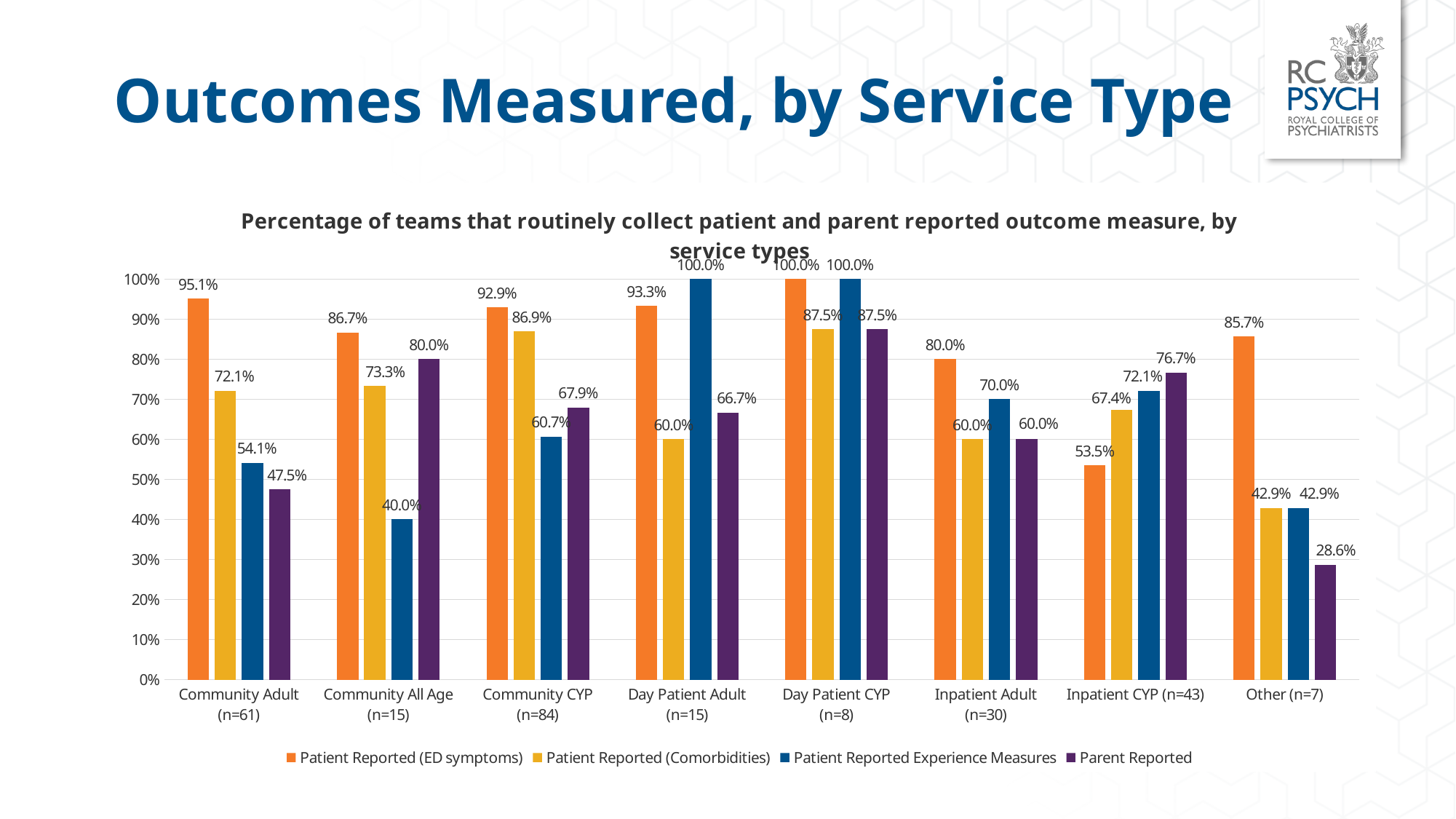
What kind of chart is shown on the slide? bar chart How many service type categories are shown on the x axis? 8 What is the value for Parent Reported for Inpatient CYP (n=43)? 76.7% Which service type has the lowest Patient Reported (ED symptoms) value? Inpatient CYP (n=43) Which is larger for Inpatient Adult (n=30): Patient Reported (ED symptoms) or Patient Reported Experience Measures? Patient Reported (ED symptoms) What is the difference between the Patient Reported (ED symptoms) and Parent Reported values for Community Adult (n=61)? 47.6% Is the Patient Reported (Comorbidities) value for Other (n=7) greater or less than 50%? less Which service type has the lowest Parent Reported value? Other (n=7) How many series does the legend list? 4 What is the value for Patient Reported (ED symptoms) for Community Adult (n=61)? 95.1% Which series is shown in orange in the legend? Patient Reported (ED symptoms) What is the value for Patient Reported Experience Measures for Community All Age (n=15)? 40.0%